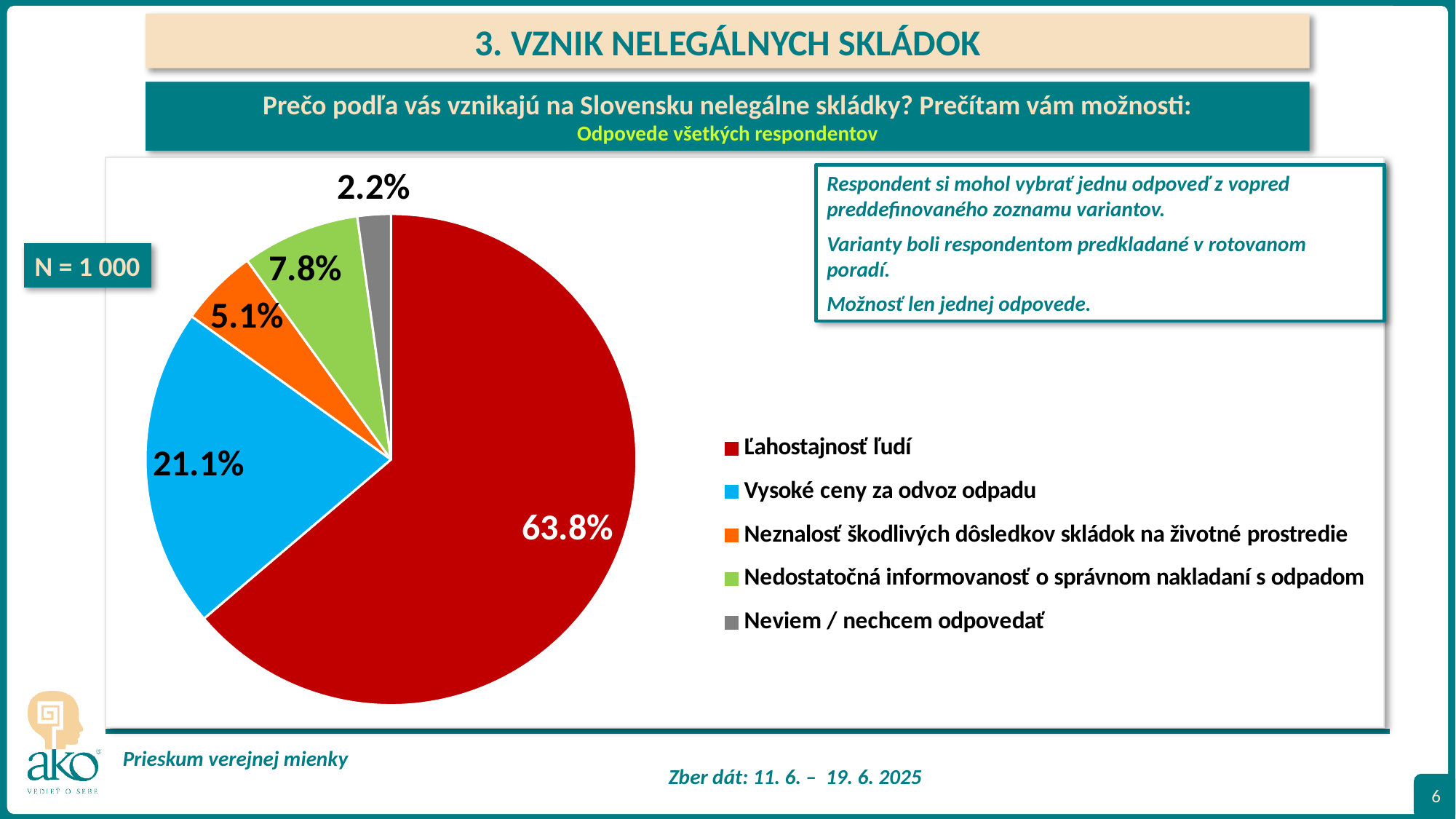
What colour is the slice for "Vysoké ceny za odvoz odpadu"? blue Which answer has the largest share of the pie? Ľahostajnosť ľudí What share of respondents chose "Nedostatočná informovanosť o správnom nakladaní s odpadom"? 7.8% What share of respondents chose "Neznalosť škodlivých dôsledkov skládok na životné prostredie"? 5.1% Which has a larger share: "Nedostatočná informovanosť o správnom nakladaní s odpadom" or "Neznalosť škodlivých dôsledkov skládok na životné prostredie"? Nedostatočná informovanosť o správnom nakladaní s odpadom How many slices does the pie chart have? 5 What is the difference in percentage points between "Ľahostajnosť ľudí" and "Vysoké ceny za odvoz odpadu"? 42.7 What share of respondents chose "Ľahostajnosť ľudí"? 63.8% What type of chart is shown on the slide? pie chart What share of respondents answered "Neviem / nechcem odpovedať"? 2.2% Which answer has the smallest share of the pie? Neviem / nechcem odpovedať What share of respondents chose "Vysoké ceny za odvoz odpadu"? 21.1%